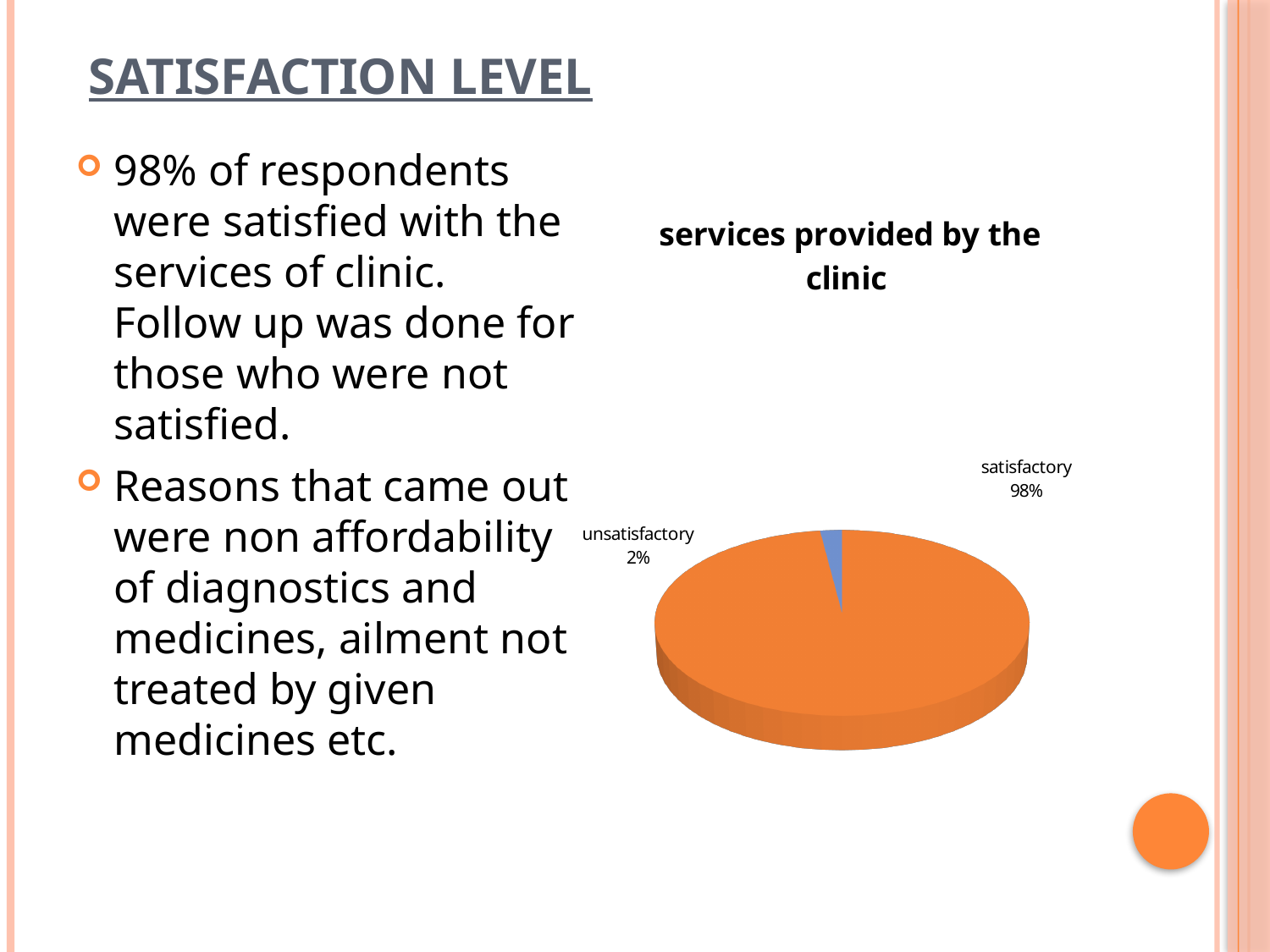
What share of the pie is labelled satisfactory? 98% How many slices does the pie chart have? 2 What is the title of the chart? services provided by the clinic Which slice of the pie is the largest? satisfactory What colour is the satisfactory slice of the pie? orange What is the difference in percentage points between the satisfactory and unsatisfactory slices? 96 What kind of chart is shown on the slide? pie chart Which slice of the pie is the smallest? unsatisfactory What share of the pie is labelled unsatisfactory? 2% Which is larger, the satisfactory slice or the unsatisfactory slice? satisfactory